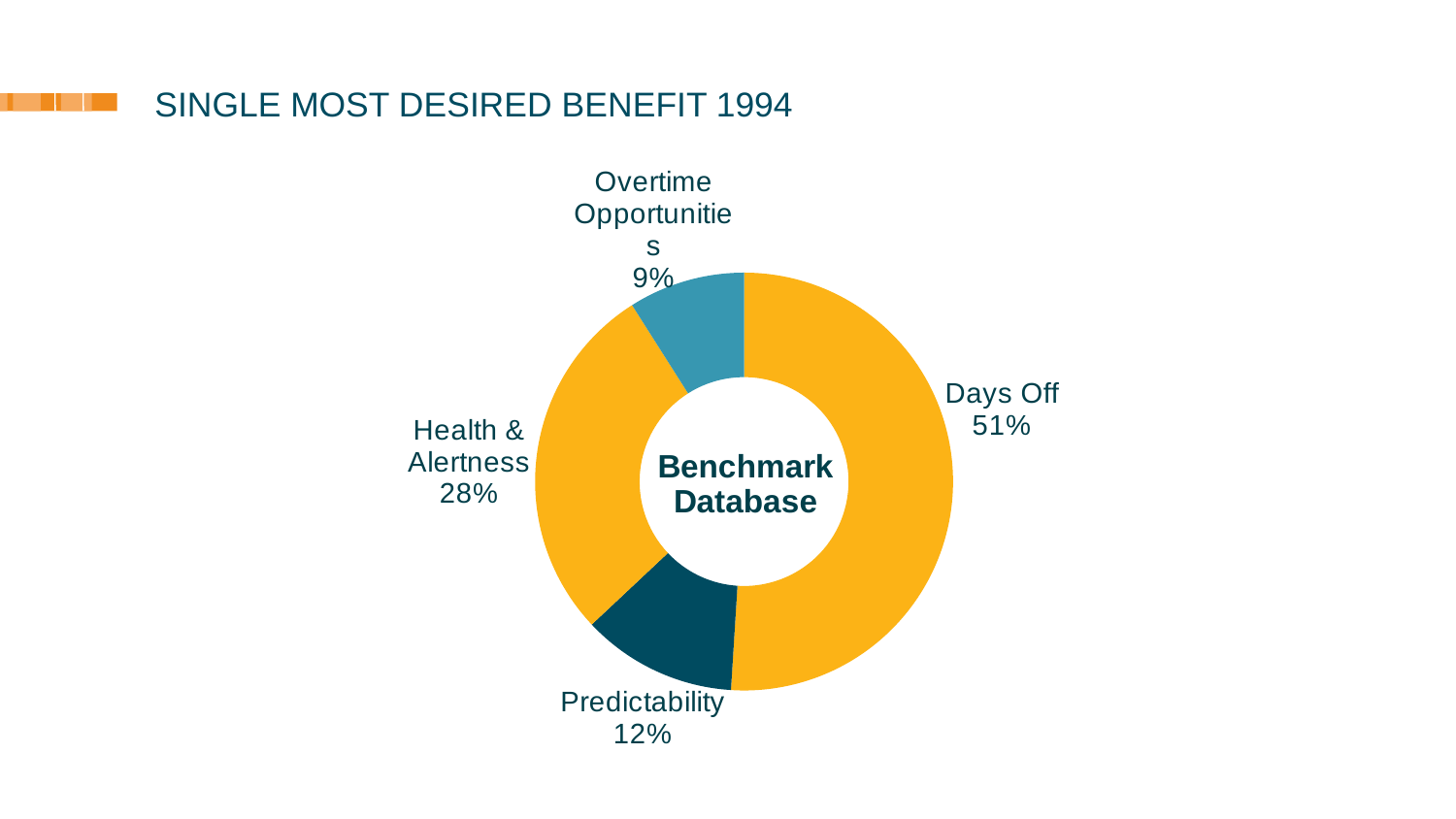
What is the difference in percentage points between Days Off and Health & Alertness? 23 What percentage is shown for Overtime Opportunities? 9% What is the title of the slide? SINGLE MOST DESIRED BENEFIT 1994 What percentage of respondents chose Days Off as the single most desired benefit? 51% What share does Health & Alertness have in the chart? 28% Which category has the smallest share of the chart? Overtime Opportunities What kind of chart is shown on the slide? Pie chart (doughnut) How many categories are shown in the chart? 4 What is the value shown for Predictability? 12% Which is larger, the share for Predictability or the share for Overtime Opportunities? Predictability Which category has the largest share of the chart? Days Off What text appears in the centre of the doughnut chart? Benchmark Database